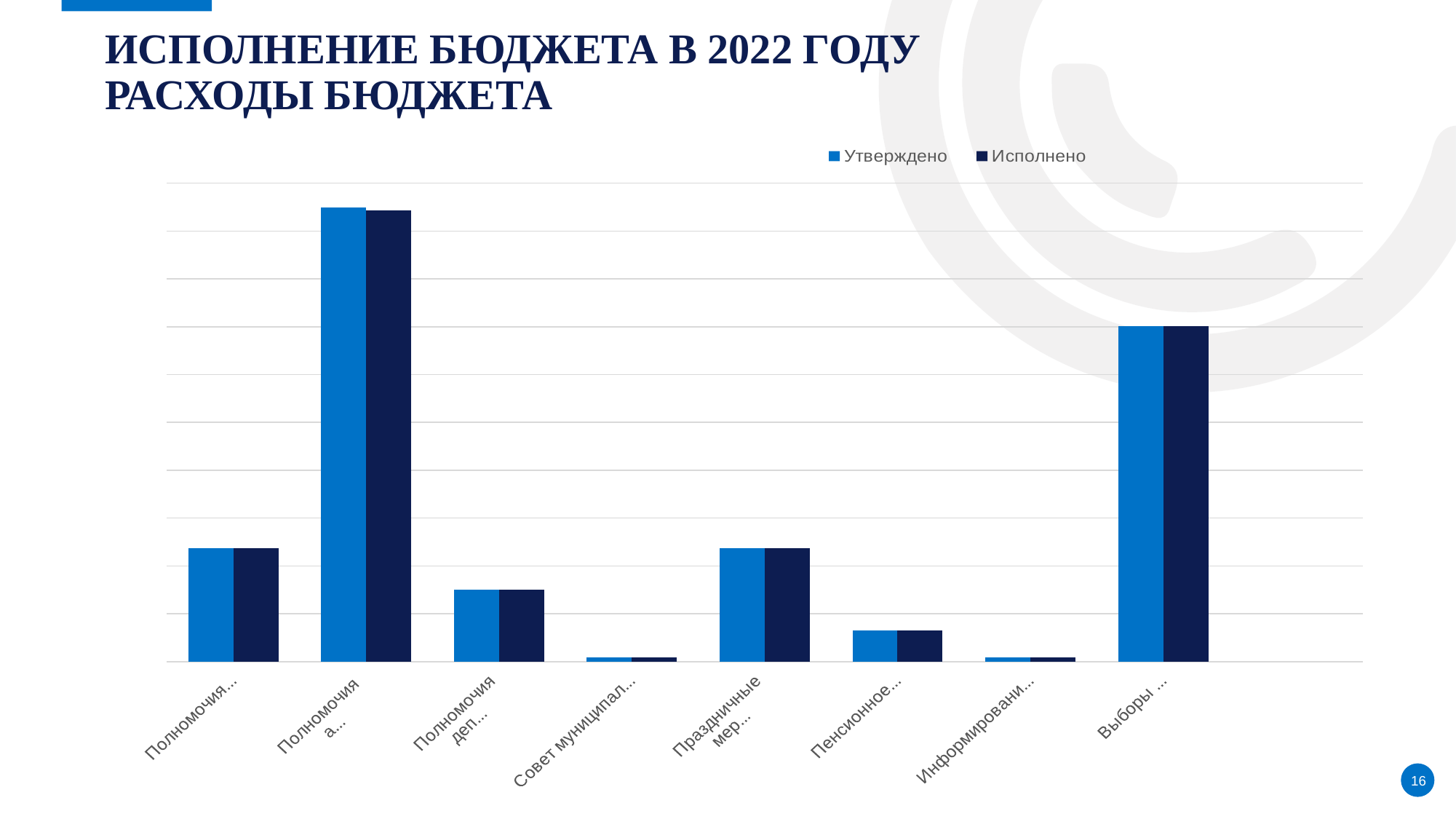
What are the two series named in the legend? Утверждено and Исполнено Which category has the second-highest bars? Выборы ... Which is larger, the Утверждено value for Полномочия а... or for Выборы ...? Полномочия а... Which is larger, the Утверждено value for Полномочия... (first category) or for Полномочия деп...? Полномочия... (first category) Which category has the highest bars? Полномочия а... Which is larger, the Исполнено value for Праздничные мер... or for Пенсионное...? Праздничные мер... How many series does the legend list? 2 What is the title of the slide containing the chart? ИСПОЛНЕНИЕ БЮДЖЕТА В 2022 ГОДУ РАСХОДЫ БЮДЖЕТА What kind of chart is shown on the slide? bar chart How many categories are shown along the x axis? 8